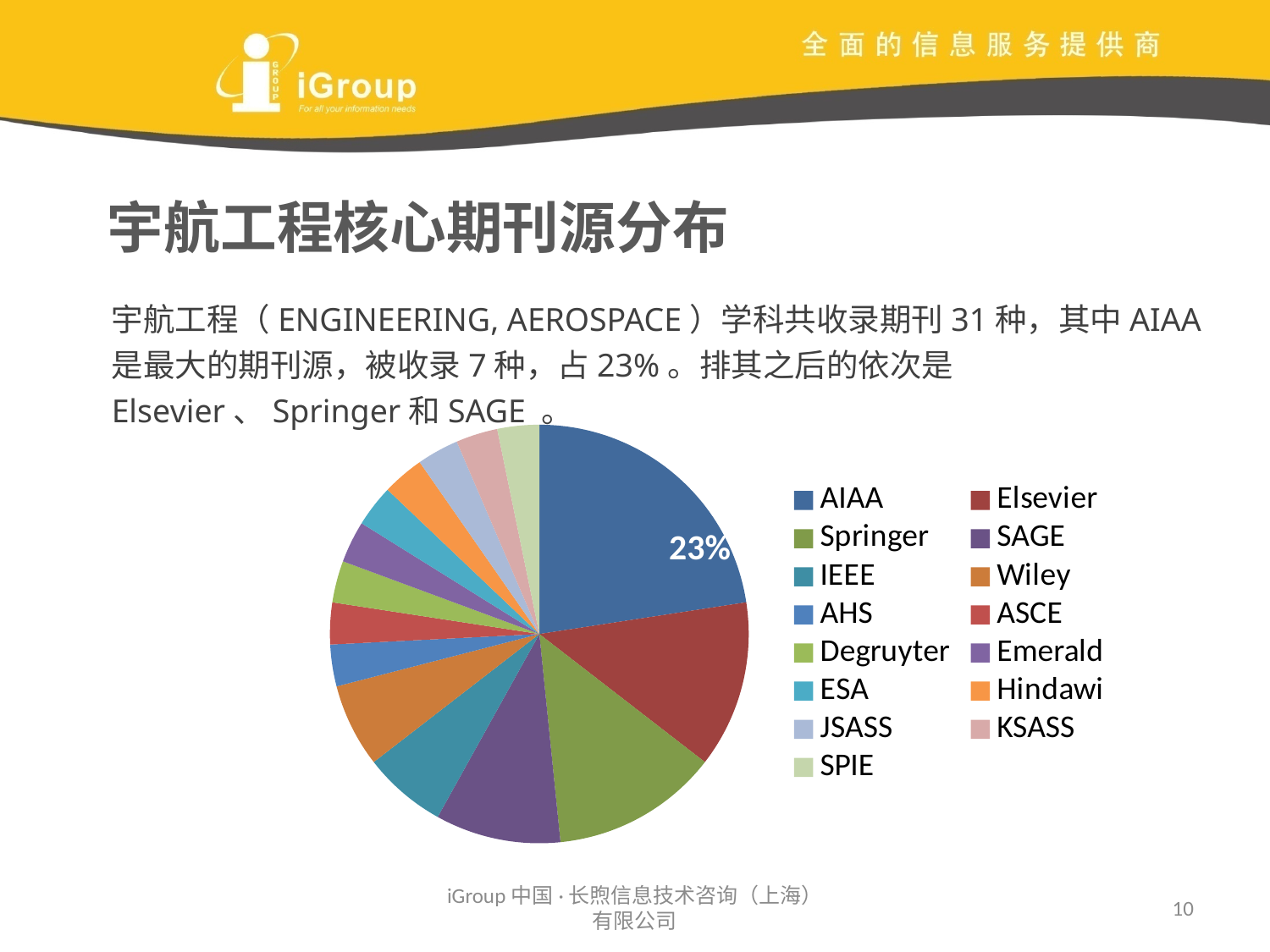
How many publishers (categories) does the pie chart's legend list? 15 Which slice is larger in the pie chart, Elsevier or SPIE? Elsevier What colour is the AIAA slice in the pie chart? blue Which legend entry is listed last in the pie chart's legend? SPIE What kind of chart is shown on the slide? pie chart What percentage is labelled on the AIAA slice of the pie chart? 23% Which slice is larger in the pie chart, Wiley or AHS? Wiley What share of the pie does AIAA account for? 23% Which publisher has the largest slice in the pie chart? AIAA Which slice is larger in the pie chart, AIAA or Elsevier? AIAA